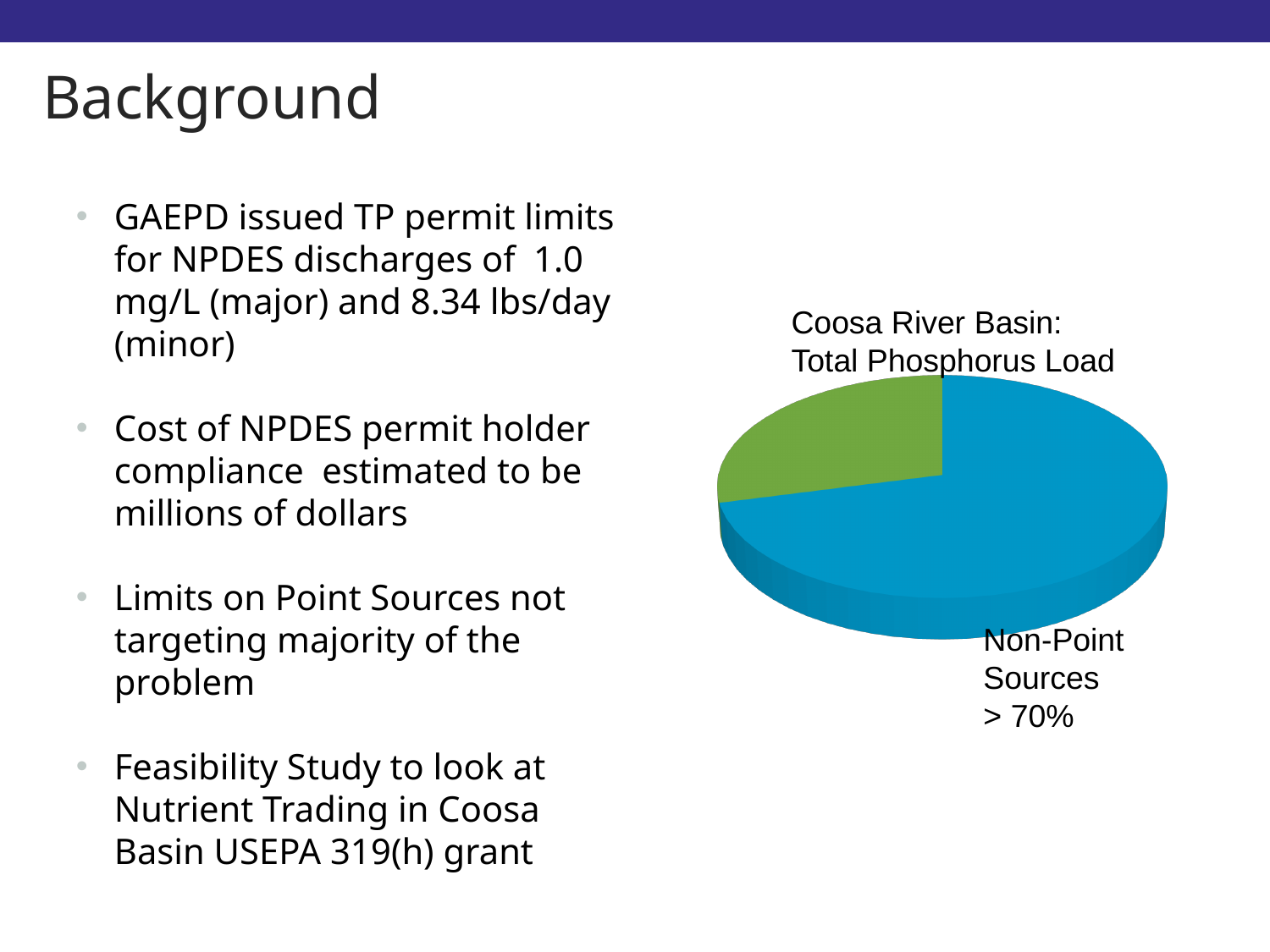
What is the title of the pie chart? Coosa River Basin: Total Phosphorus Load How many slices does the pie chart have? 2 What kind of chart is shown on the slide? pie chart What label is printed next to the blue slice of the pie chart? Non-Point Sources > 70% What colour is the Non-Point Sources slice in the pie chart? blue Which slice of the pie chart is the largest? Non-Point Sources Is the share of the pie for Non-Point Sources greater or less than 50%? greater